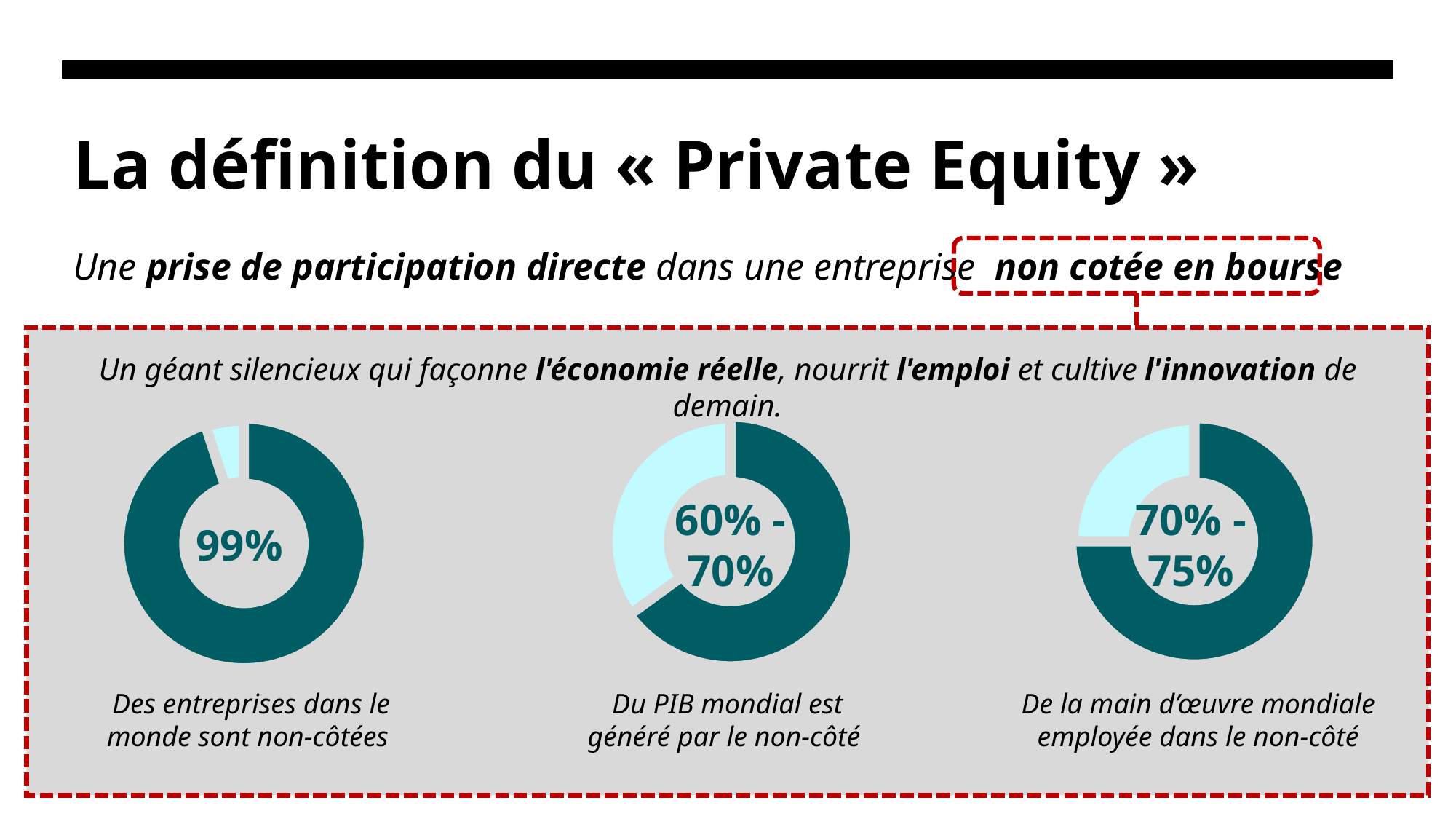
What value is shown in the centre of the right donut chart (De la main d'œuvre mondiale employée dans le non-côté)? 70% - 75% Is the share shown in the left donut chart (entreprises non-côtées) larger or smaller than the share in the middle donut chart (PIB mondial)? Larger What value is shown in the centre of the middle donut chart (Du PIB mondial est généré par le non-côté)? 60% - 70% Which donut chart shows the highest share: the left one (entreprises non-côtées), the middle one (PIB mondial) or the right one (main d'œuvre mondiale)? The left one (99%) What colour is the larger slice in each of the three donut charts? Dark teal Which donut chart shows the lowest share: the left one (entreprises non-côtées), the middle one (PIB mondial) or the right one (main d'œuvre mondiale)? The middle one (60% - 70%) In the middle donut chart (Du PIB mondial est généré par le non-côté), is the dark teal slice greater or less than 50%? greater How many slices does each donut chart contain? 2 What value is shown in the centre of the left donut chart (Des entreprises dans le monde sont non-côtées)? 99% How many donut charts are shown on the slide? 3 What kind of chart is used for the three figures on the slide? Donut (pie) chart